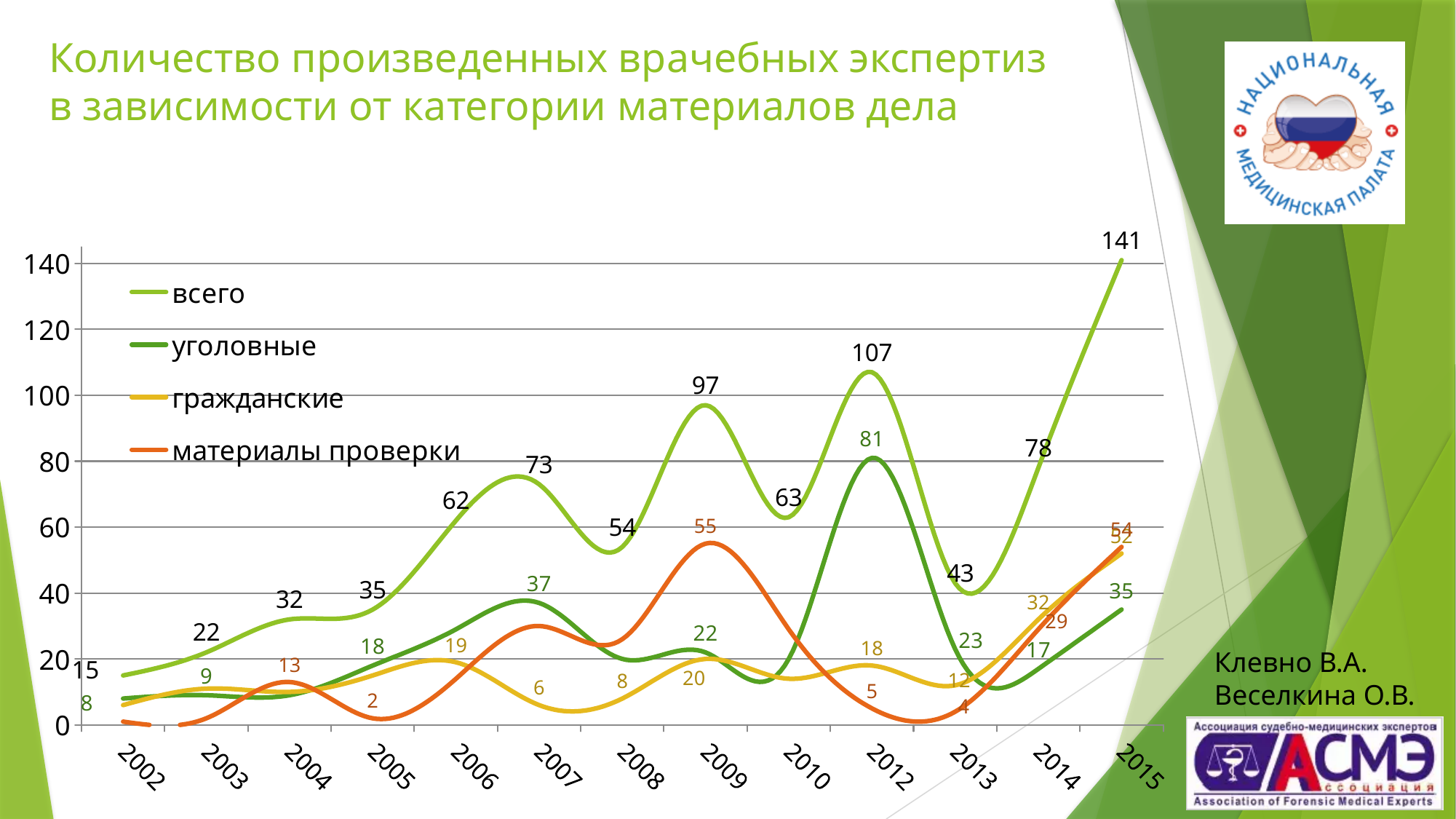
In which year does the всего series have its lowest value? 2002 What is the value of the всего series in 2015? 141 In which year does the всего series reach its highest value? 2015 Which series is drawn in orange according to the legend? материалы проверки How many series does the legend list? 4 Which is larger: the всего value for 2009 or for 2012? 2012 How many years are shown on the x axis? 13 What is the value of the уголовные series in 2012? 81 What kind of chart is shown on the slide? line chart What is the value of the материалы проверки series in 2009? 55 What is the difference between the всего values for 2015 and 2014? 63 What is the value of the гражданские series in 2015? 52